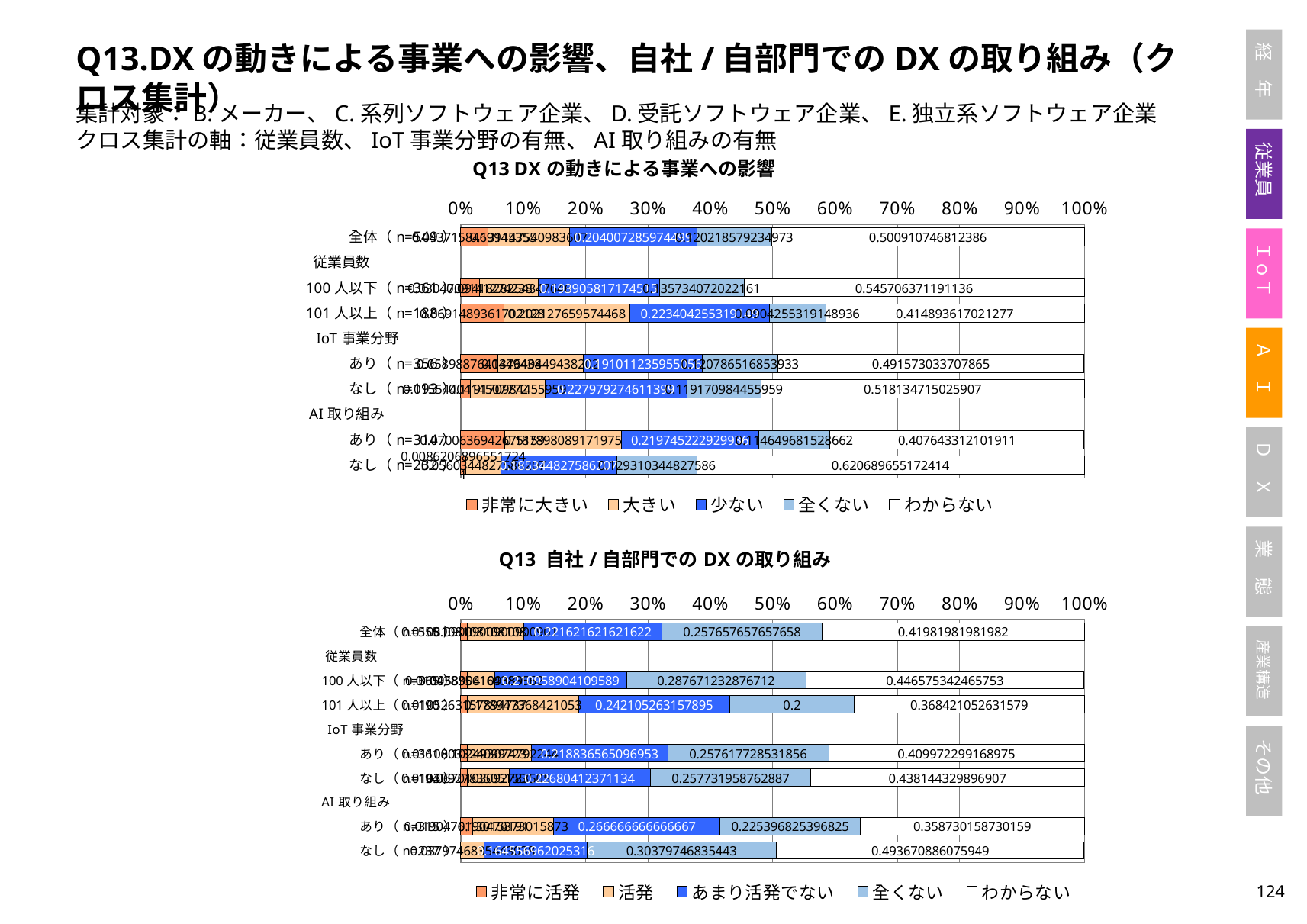
In the bottom chart 'Q13 自社/自部門でのDXの取り組み', what is the value of あまり活発でない for AI取り組み あり? 0.266666666666667 In the top chart 'Q13 DXの動きによる事業への影響', how many series does the legend list? 5 In the top chart 'Q13 DXの動きによる事業への影響', which row has the highest value for わからない? AI取り組み なし In the bottom chart 'Q13 自社/自部門でのDXの取り組み', what is the value of わからない for 全体? 0.41981981981982 In the bottom chart 'Q13 自社/自部門でのDXの取り組み', what is the value of 全くない for 101人以上? 0.2 In the bottom chart 'Q13 自社/自部門でのDXの取り組み', what is the difference between わからない and 全くない for 全体? 0.162162162162162 What type of chart is the bottom chart 'Q13 自社/自部門でのDXの取り組み'? Stacked bar chart In the bottom chart 'Q13 自社/自部門でのDXの取り組み', is the value of わからない for AI取り組み なし greater or less than 40%? greater In the top chart 'Q13 DXの動きによる事業への影響', what is the value of わからない for AI取り組み なし? 0.620689655172414 In the top chart 'Q13 DXの動きによる事業への影響', what is the value of わからない for 全体? 0.500910746812386 In the bottom chart 'Q13 自社/自部門でのDXの取り組み', which row has the lowest value for わからない? AI取り組み あり In the top chart 'Q13 DXの動きによる事業への影響', which is larger for わからない: 100人以下 or 101人以上? 100人以下